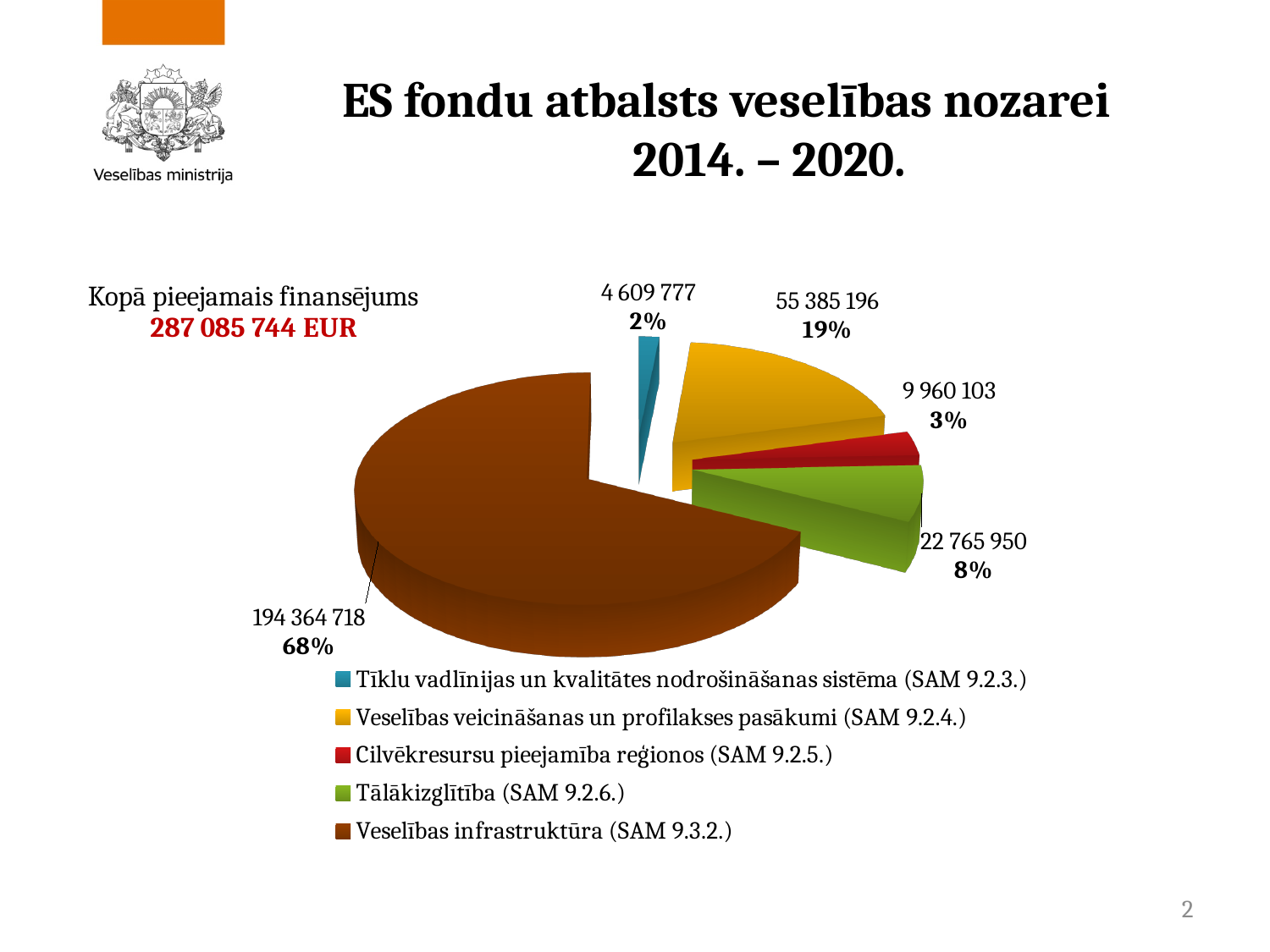
What is the value for Veselības veicināšanas un profilakses pasākumi (SAM 9.2.4.)? 55 385 196 Which category has the largest slice of the pie? Veselības infrastruktūra (SAM 9.3.2.) What is the value for Tālākizglītība (SAM 9.2.6.)? 22 765 950 What is the value for Veselības infrastruktūra (SAM 9.3.2.)? 194 364 718 What share of the pie does Cilvēkresursu pieejamība reģionos (SAM 9.2.5.) represent? 3% What kind of chart is shown on the slide? pie chart Which is larger, the value for Tālākizglītība (SAM 9.2.6.) or the value for Cilvēkresursu pieejamība reģionos (SAM 9.2.5.)? Tālākizglītība (SAM 9.2.6.) What share of the pie does Tīklu vadlīnijas un kvalitātes nodrošināšanas sistēma (SAM 9.2.3.) represent? 2% How many slices does the pie chart have? 5 Which category has the smallest slice of the pie? Tīklu vadlīnijas un kvalitātes nodrošināšanas sistēma (SAM 9.2.3.) What is the difference between the values for Veselības veicināšanas un profilakses pasākumi (SAM 9.2.4.) and Tālākizglītība (SAM 9.2.6.)? 32 619 246 How many entries does the legend list? 5